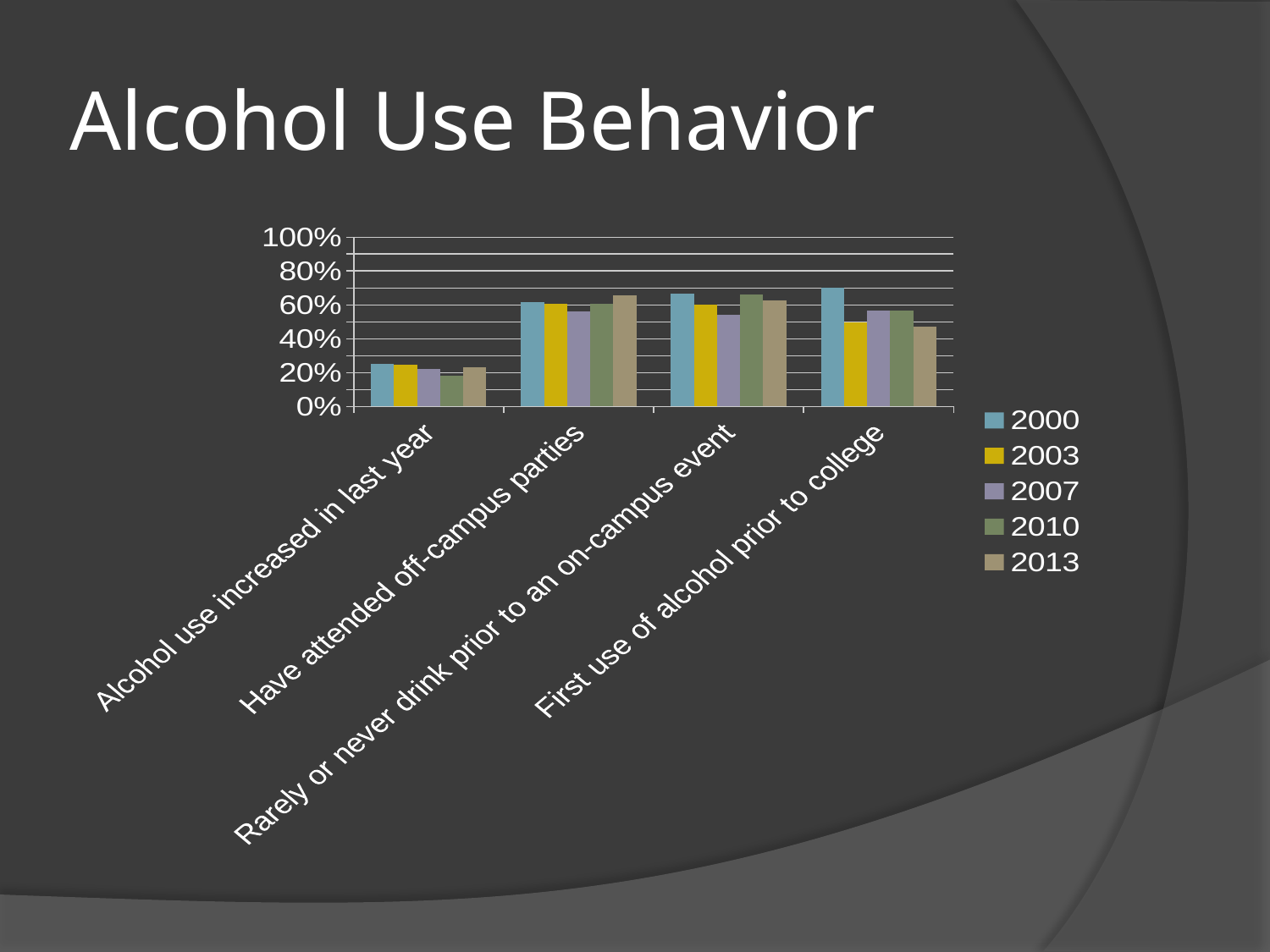
For "First use of alcohol prior to college", which year has the highest value? 2000 For "First use of alcohol prior to college", which is larger: the 2000 value or the 2013 value? 2000 What kind of chart is shown on the slide? Bar chart What is the title of the slide containing the chart? Alcohol Use Behavior For "Alcohol use increased in last year", which year has the lowest value? 2010 Is the 2013 value for "First use of alcohol prior to college" greater or less than 60%? less Is the 2000 value for "Alcohol use increased in last year" greater or less than 40%? less Which years are listed in the chart's legend? 2000, 2003, 2007, 2010, 2013 Is the 2000 value for "First use of alcohol prior to college" greater or less than 60%? greater How many categories are shown along the x axis of the chart? 4 How many series does the chart's legend list? 5